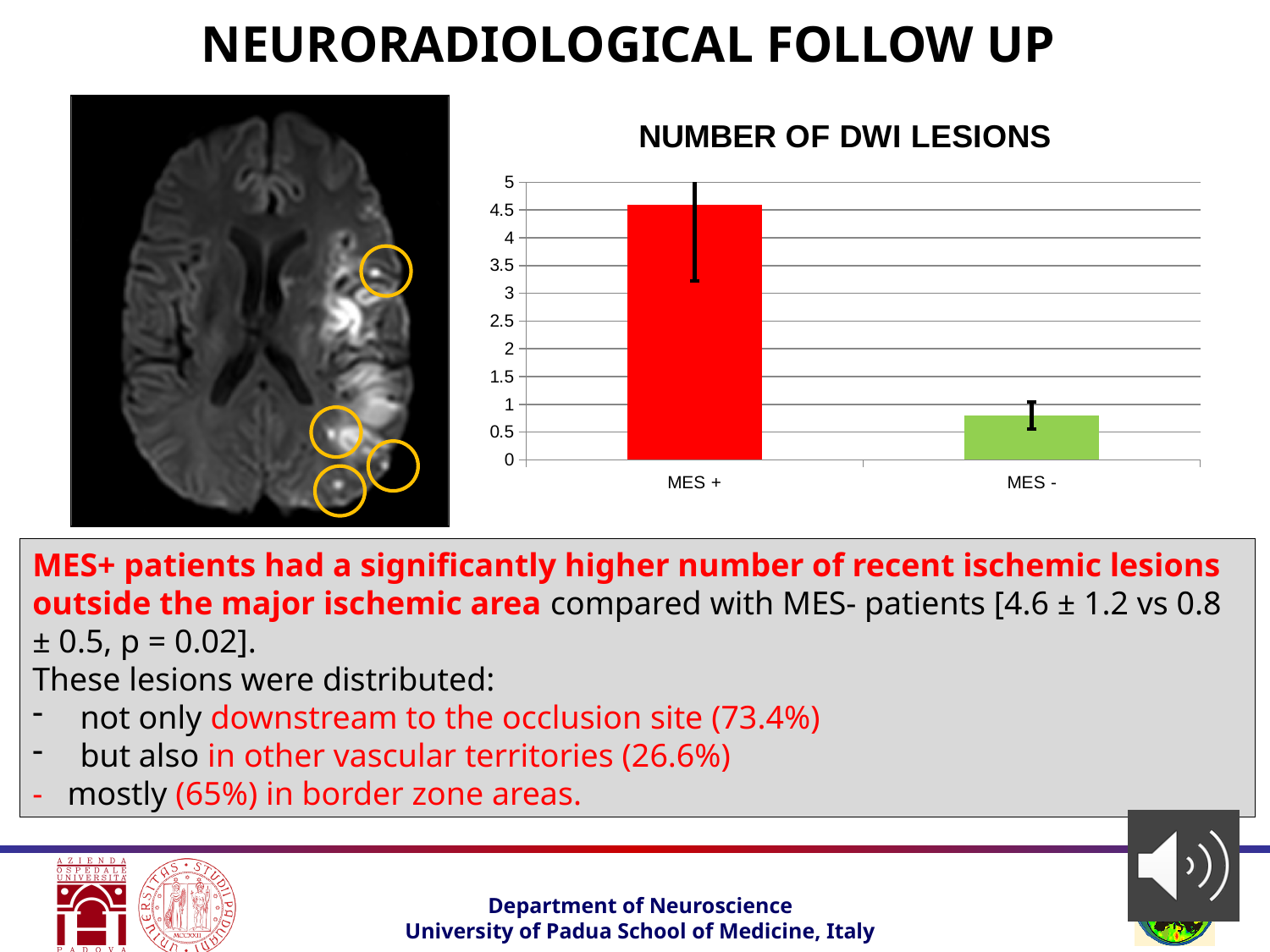
Is the value for MES + in the chart greater or less than 4? greater What is the highest tick value shown on the y axis of the chart? 5 Which category has the lowest number of DWI lesions in the chart? MES - How many categories are shown on the x axis of the chart? 2 Is the value for MES - in the chart greater or less than 1? less Is the value for MES + in the chart greater or less than 5? less What is the title of the chart on the slide? NUMBER OF DWI LESIONS What kind of chart is shown on the slide? bar chart What colour is the MES + bar in the chart? red Which category has the highest number of DWI lesions in the chart? MES + Which bar is taller in the chart, MES + or MES -? MES +